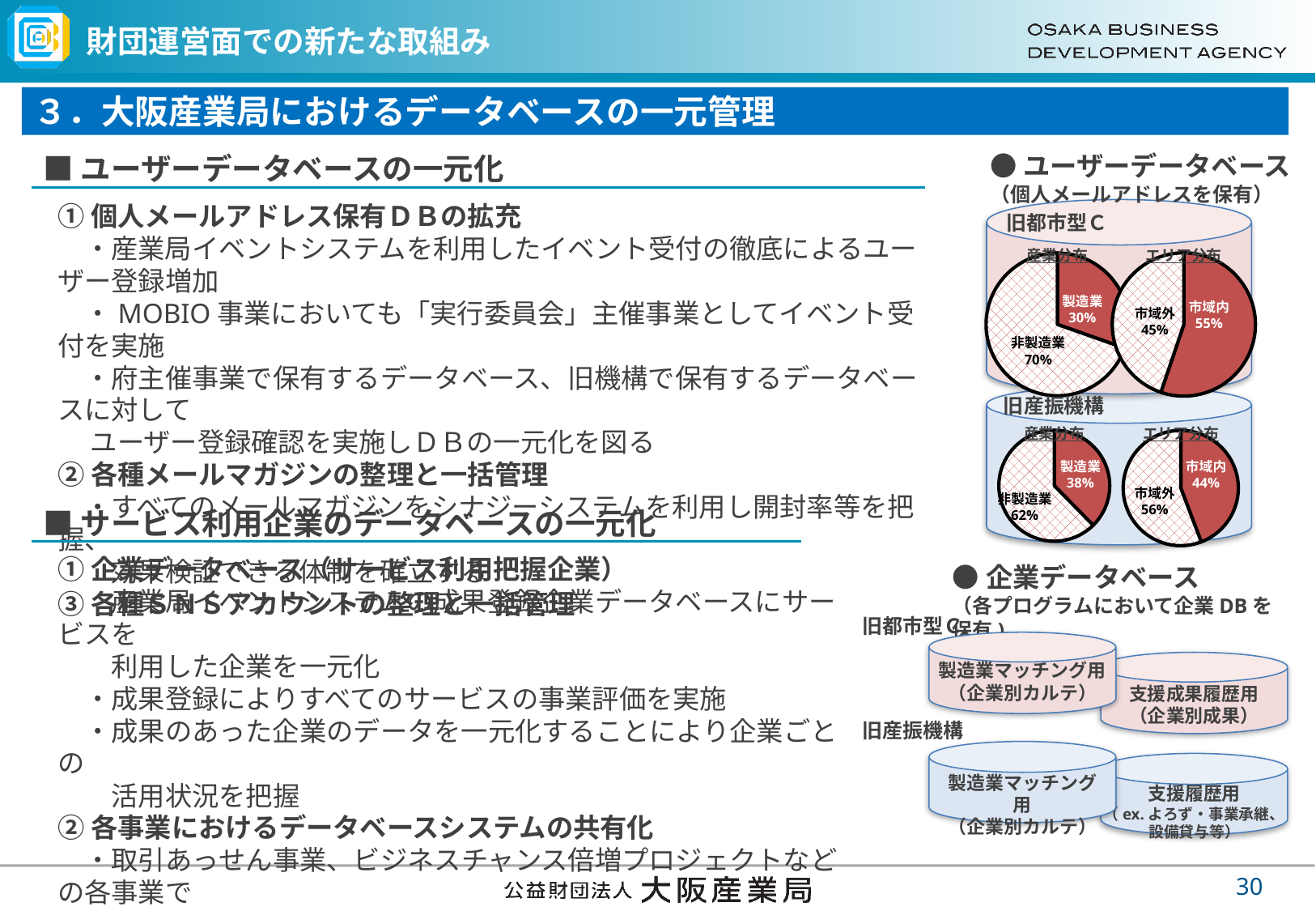
In the 旧都市型C エリア分布 pie chart, what share is 市域内? 55% In the 旧都市型C 産業分布 pie chart, what share is 製造業? 30% In the 旧都市型C 産業分布 pie chart, what share is 非製造業? 70% In the 旧都市型C 産業分布 pie chart, what is the difference between the 非製造業 and 製造業 shares? 40% What type of chart is used to show the 産業分布 and エリア分布 in the ユーザーデータベース section? Pie chart In the 旧産振機構 産業分布 pie chart, what share is 非製造業? 62% In the 旧産振機構 産業分布 pie chart, what share is 製造業? 38% In the 旧産振機構 産業分布 pie chart, which slice is the largest? 非製造業 In the 旧産振機構 エリア分布 pie chart, which slice is larger, 市域内 or 市域外? 市域外 In the 旧産振機構 エリア分布 pie chart, what share is 市域内? 44% How many pie charts are shown in the ユーザーデータベース section? 4 In the 旧都市型C エリア分布 pie chart, what share is 市域外? 45%